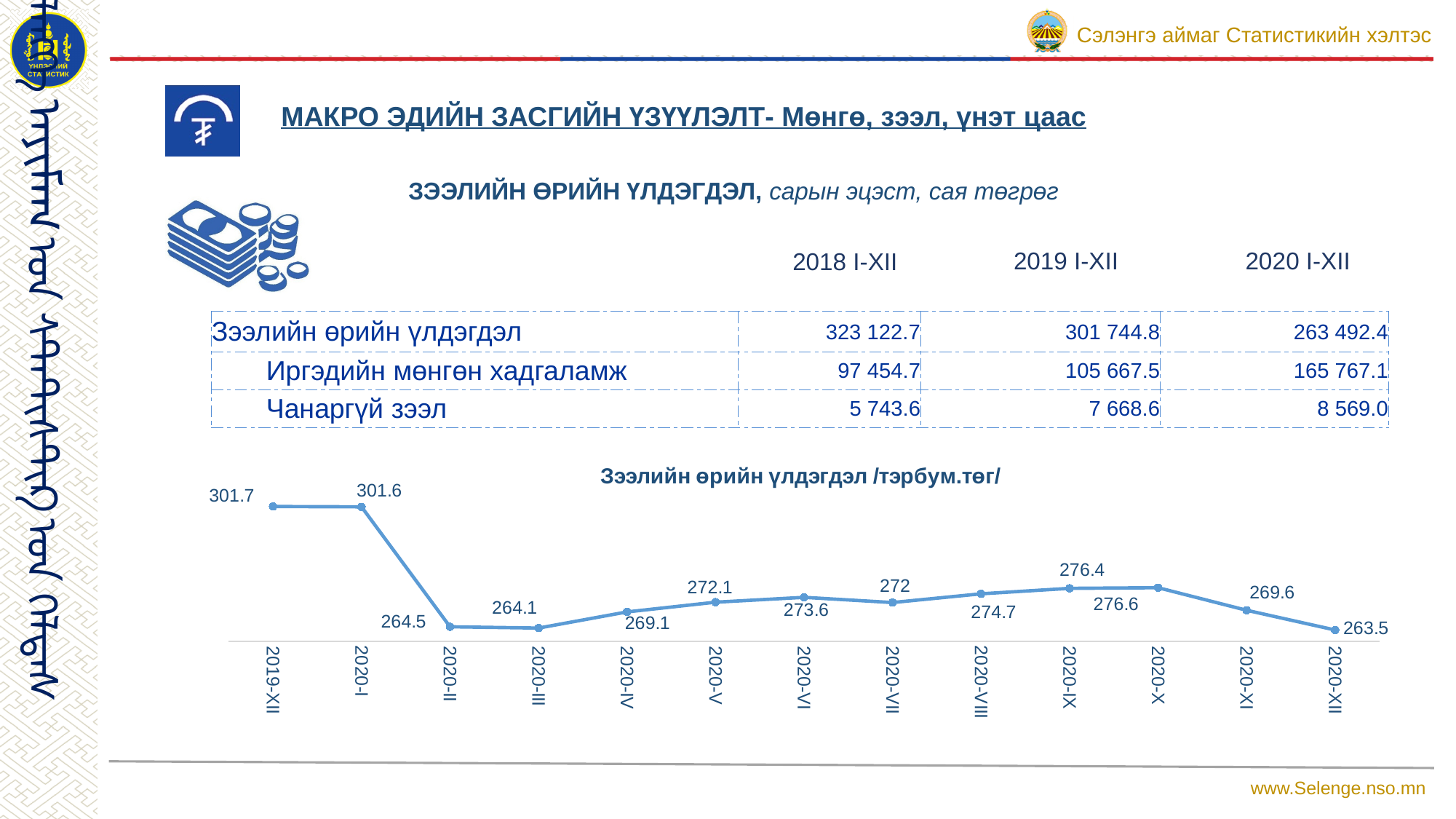
Which period has the highest value? 2019-XII Do the values rise or fall from 2020-X to 2020-XII? fall What is the difference between the values for 2020-I and 2020-II? 37.1 What is the title of the chart? Зээлийн өрийн үлдэгдэл /тэрбум.төг/ What is the value for 2020-XII? 263.5 What type of chart is shown on the slide? line chart What is the value for 2020-X? 276.6 Which period has the lowest value? 2020-XII How many data points are plotted on the chart? 13 Which is larger, the value for 2020-IX or the value for 2020-XI? 2020-IX What is the value for 2019-XII? 301.7 What is the value for 2020-II? 264.5